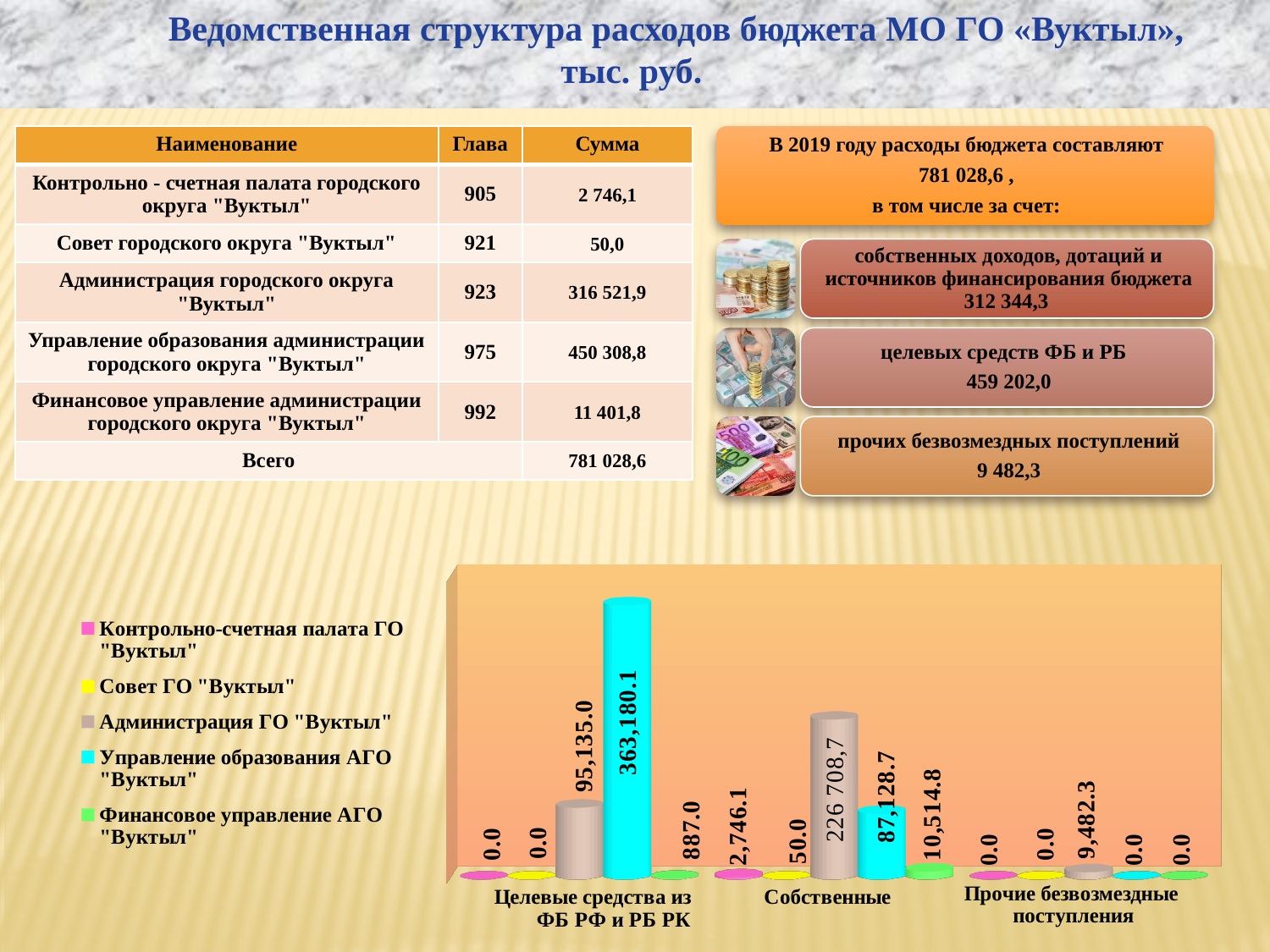
What kind of chart is shown at the bottom of the slide? bar chart In the category Целевые средства из ФБ РФ и РБ РК, what is the difference between the values for Управление образования АГО "Вуктыл" and Администрация ГО "Вуктыл"? 268,045.1 Which series has the highest value in the category Собственные? Администрация ГО "Вуктыл" What is the value for Администрация ГО "Вуктыл" in the category Прочие безвозмездные поступления? 9,482.3 What is the value for Финансовое управление АГО "Вуктыл" in the category Собственные? 10,514.8 What is the value for Администрация ГО "Вуктыл" in the category Целевые средства из ФБ РФ и РБ РК? 95,135.0 Which series has the highest value in the category Целевые средства из ФБ РФ и РБ РК? Управление образования АГО "Вуктыл" How many series does the legend of the bar chart list? 5 What is the value for Управление образования АГО "Вуктыл" in the category Целевые средства из ФБ РФ и РБ РК? 363,180.1 What is the value for Контрольно-счетная палата ГО "Вуктыл" in the category Собственные? 2,746.1 In the category Собственные, which is larger: the value for Управление образования АГО "Вуктыл" or for Финансовое управление АГО "Вуктыл"? Управление образования АГО "Вуктыл" How many categories are shown along the x axis of the bar chart? 3